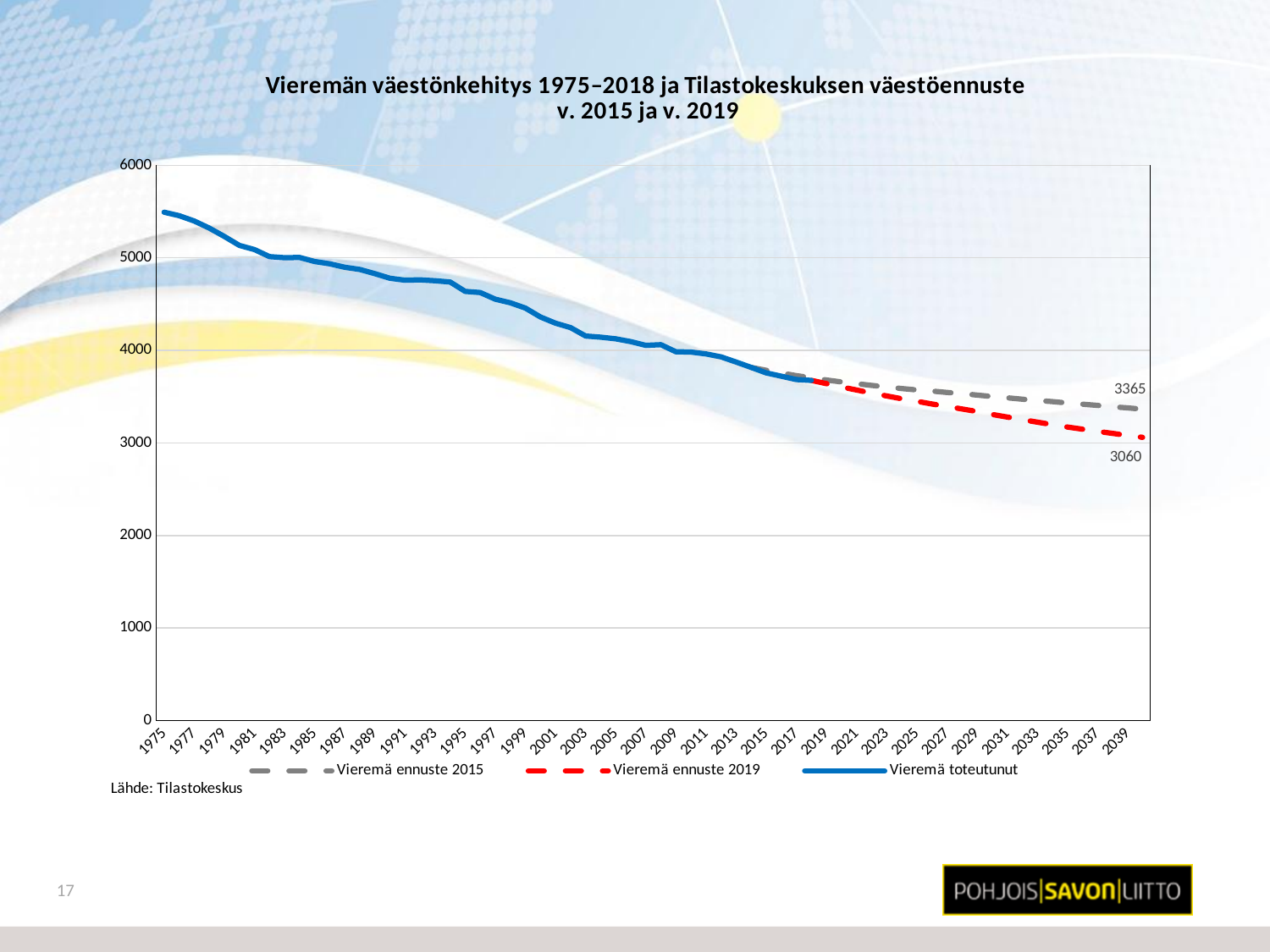
Is the value of Vieremä toteutunut in 1975 greater or less than 5000? greater Does the Vieremä toteutunut series rise or fall from 1975 to 2018? fall What colour is the Vieremä toteutunut line? blue What is the title of the chart? Vieremän väestönkehitys 1975–2018 ja Tilastokeskuksen väestöennuste v. 2015 ja v. 2019 Is the value of Vieremä toteutunut in 2017 greater or less than 4000? less What is the difference between the labelled end values of the 2015 forecast (3365) and the 2019 forecast (3060)? 305 What kind of chart is shown on the slide? line chart What is the labelled end value of the Vieremä ennuste 2015 series? 3365 Which forecast series ends at a higher value, Vieremä ennuste 2015 or Vieremä ennuste 2019? Vieremä ennuste 2015 What is the labelled end value of the Vieremä ennuste 2019 series? 3060 Is the value of Vieremä toteutunut in 1995 greater or less than 4000? greater How many series does the legend list? 3